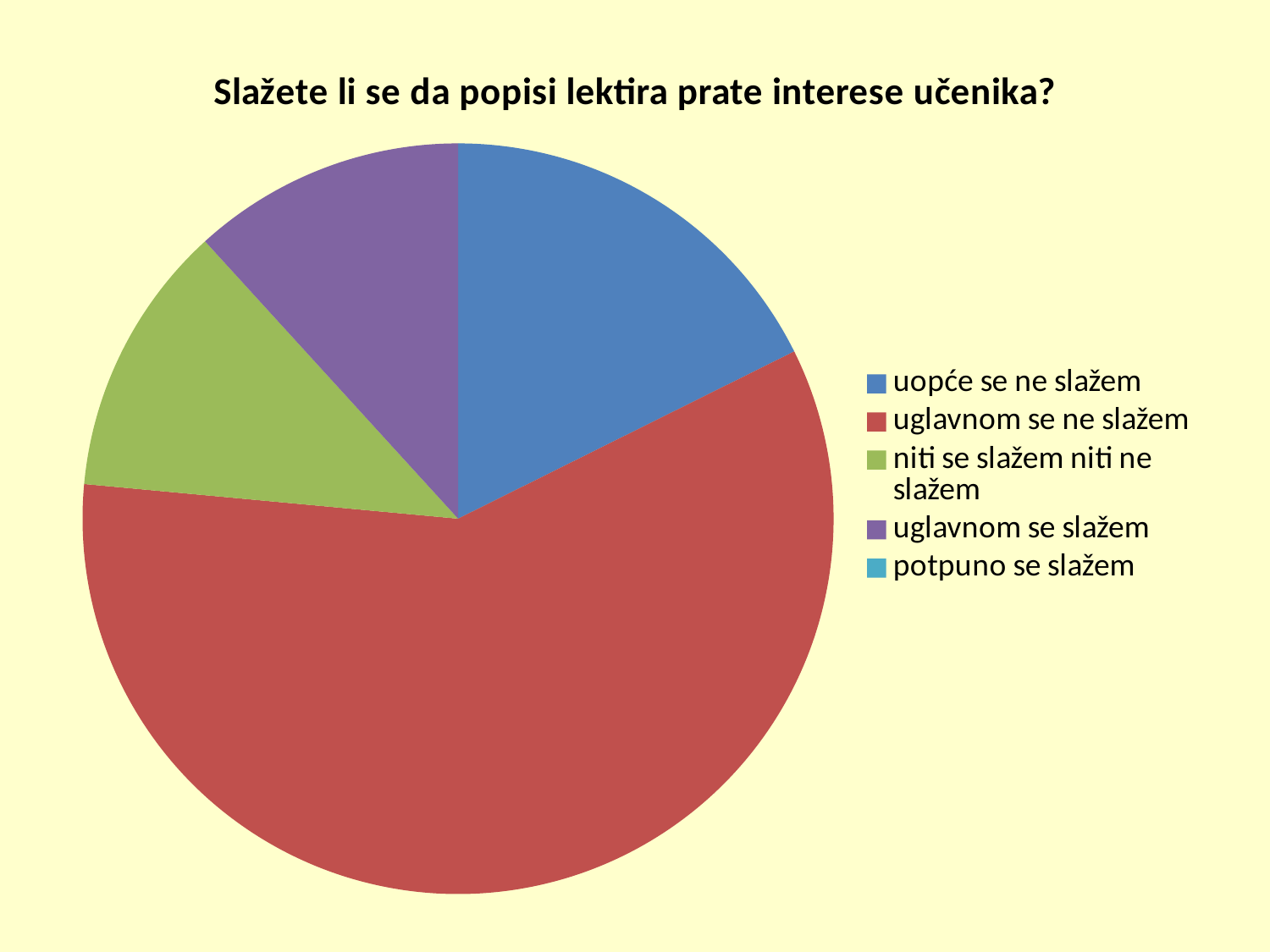
What is the title of the chart? Slažete li se da popisi lektira prate interese učenika? How many slices are visible in the pie? 4 Which slice is larger: 'uopće se ne slažem' or 'uglavnom se slažem'? uopće se ne slažem Which slice is larger: 'uglavnom se ne slažem' or 'niti se slažem niti ne slažem'? uglavnom se ne slažem What colour is the slice for 'uglavnom se ne slažem'? red Which category has the largest slice of the pie? uglavnom se ne slažem Does the slice for 'uglavnom se ne slažem' take up more or less than half of the pie? more What kind of chart is shown on the slide? pie chart How many entries does the chart's legend list? 5 Which legend entry has no visible slice in the pie? potpuno se slažem